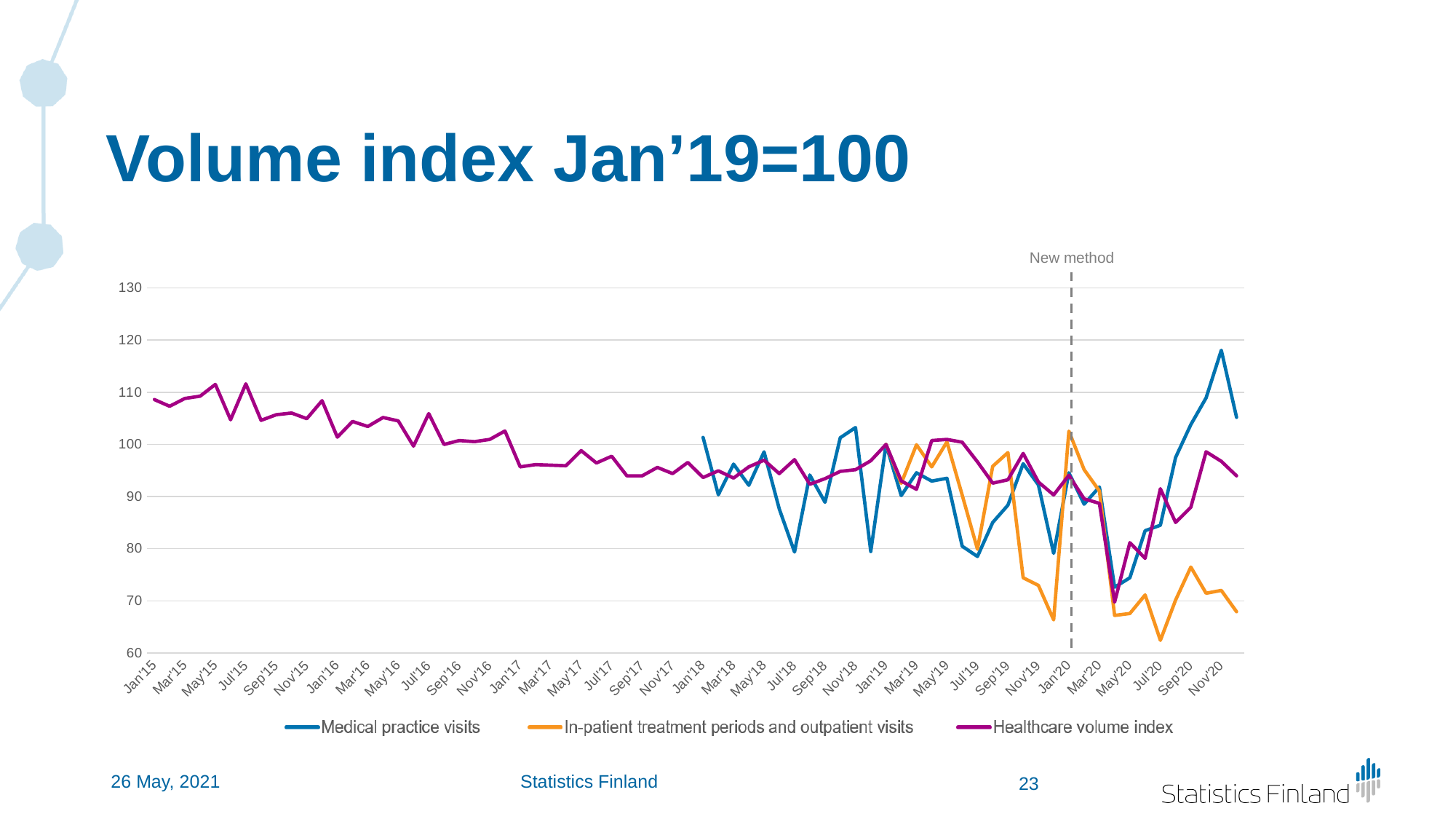
Is the lowest value of In-patient treatment periods and outpatient visits in mid-2020 greater or less than 70? less Is the peak value of Medical practice visits in late 2020 greater or less than 110? greater Is the Healthcare volume index at Jan'15 greater or less than 100? greater What kind of chart is shown on the slide? Line chart What label is attached to the dashed vertical line near Jan'20? New method At Nov'20, which is higher: Medical practice visits or In-patient treatment periods and outpatient visits? Medical practice visits Which series reaches the highest value anywhere on the chart? Medical practice visits Does the Healthcare volume index generally rise or fall from Jan'15 to the end of 2017? fall How many series does the legend list? 3 What is the title of the chart on the slide? Volume index Jan'19=100 Which series reaches the lowest value anywhere on the chart? In-patient treatment periods and outpatient visits